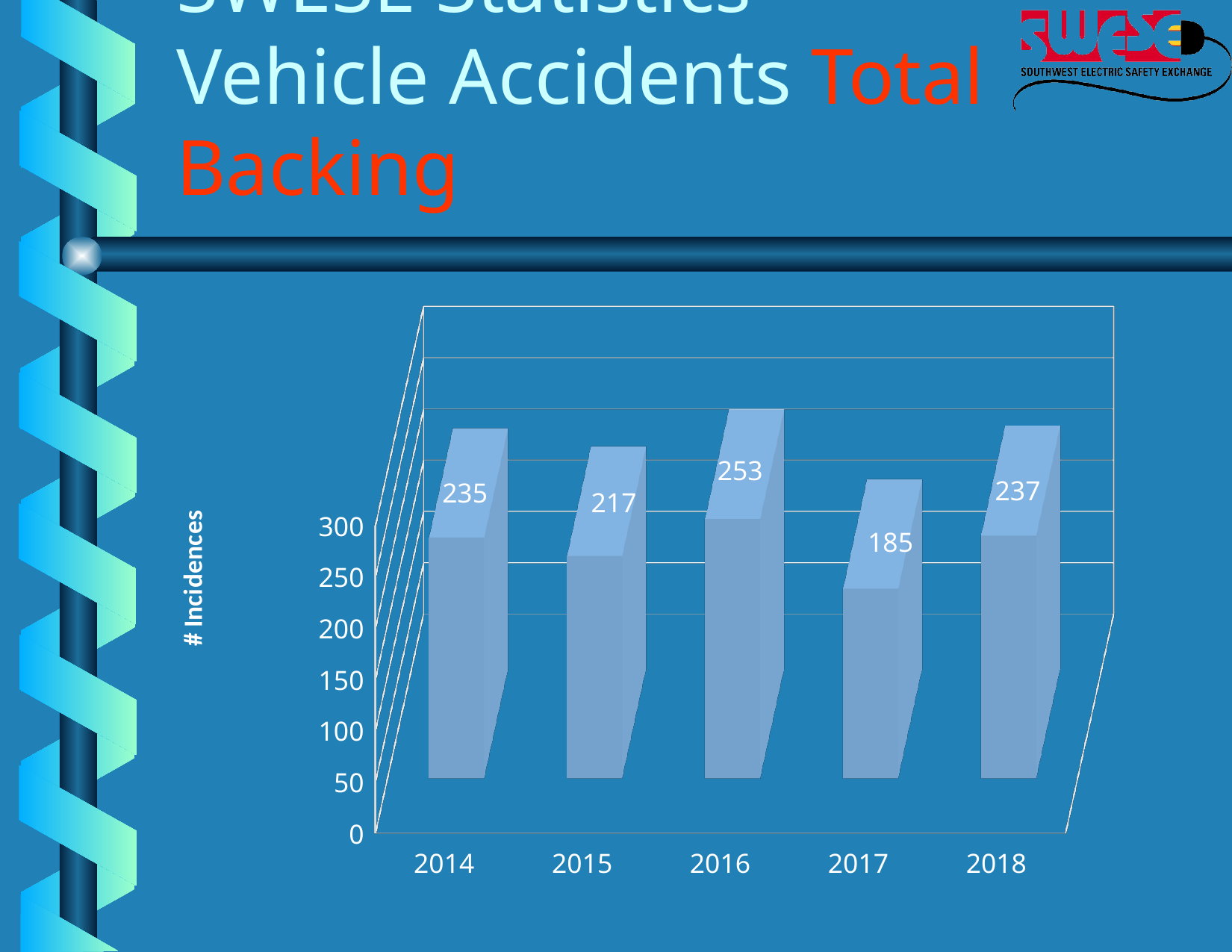
What is the difference in incidences between 2016 and 2017? 68 What is the number of incidences for 2014? 235 Did the number of incidences rise or fall from 2016 to 2017? Fall What is the number of incidences for 2018? 237 What is the label on the vertical axis of the chart? # Incidences Which year has more incidences, 2015 or 2018? 2018 Which year has the lowest number of incidences? 2017 What is the difference in incidences between 2014 and 2015? 18 What is the number of incidences for 2017? 185 How many years are shown on the x axis of the chart? 5 What kind of chart is shown on the slide? Bar chart Which year has the highest number of incidences? 2016